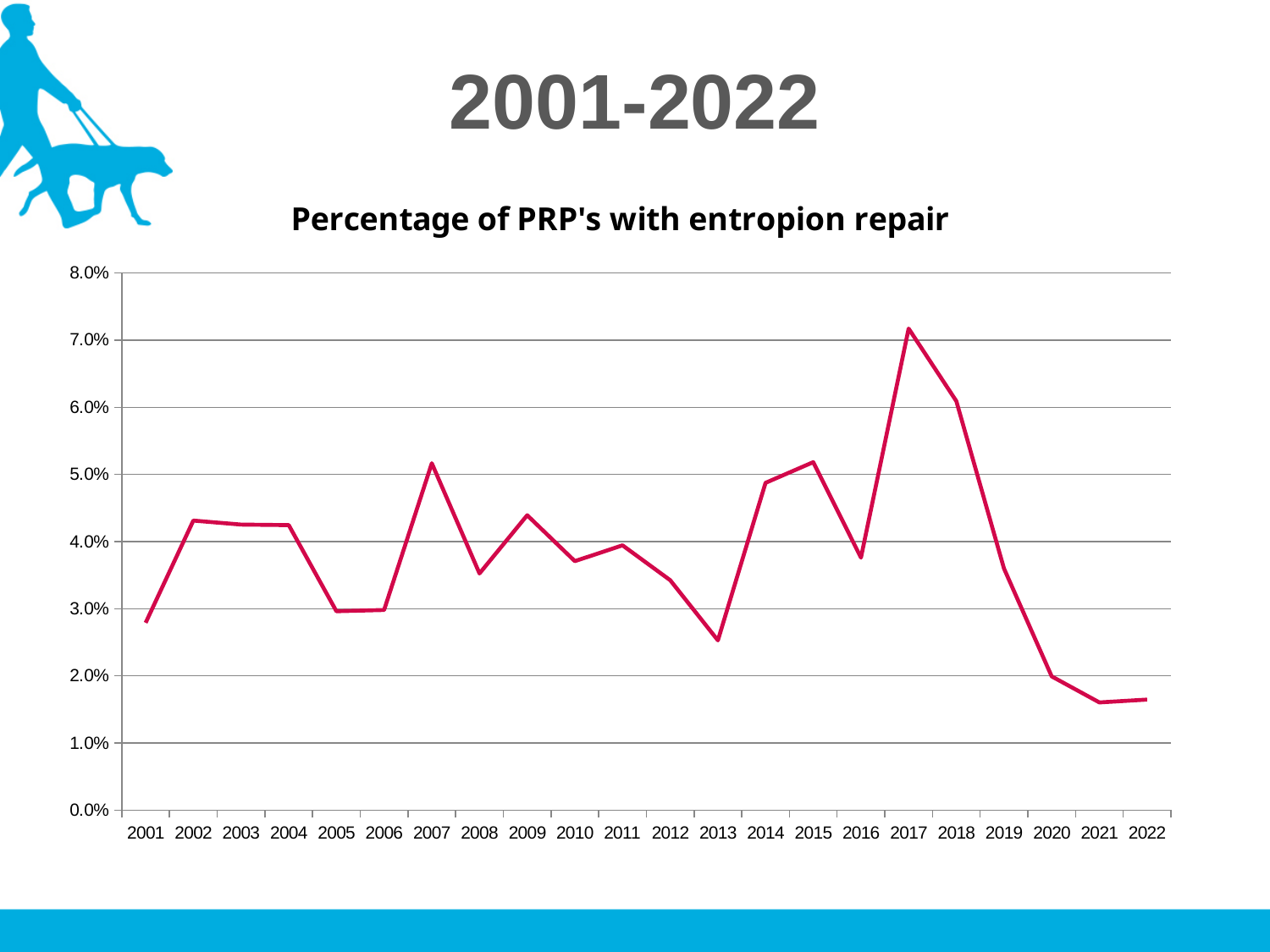
Which year has the larger value, 2002 or 2005? 2002 Which year has the larger value, 2015 or 2016? 2015 Is the value for 2013 greater or less than 3.0%? less How many years are plotted along the x axis? 22 Do the values rise or fall from 2018 to 2021? fall Is the value for 2007 greater or less than 4.0%? greater Which year has the highest percentage of PRP's with entropion repair? 2017 Is the value for 2017 greater or less than 6.0%? greater What kind of chart is shown on the slide? line chart What colour is the plotted line? red What is the title of the chart? Percentage of PRP's with entropion repair